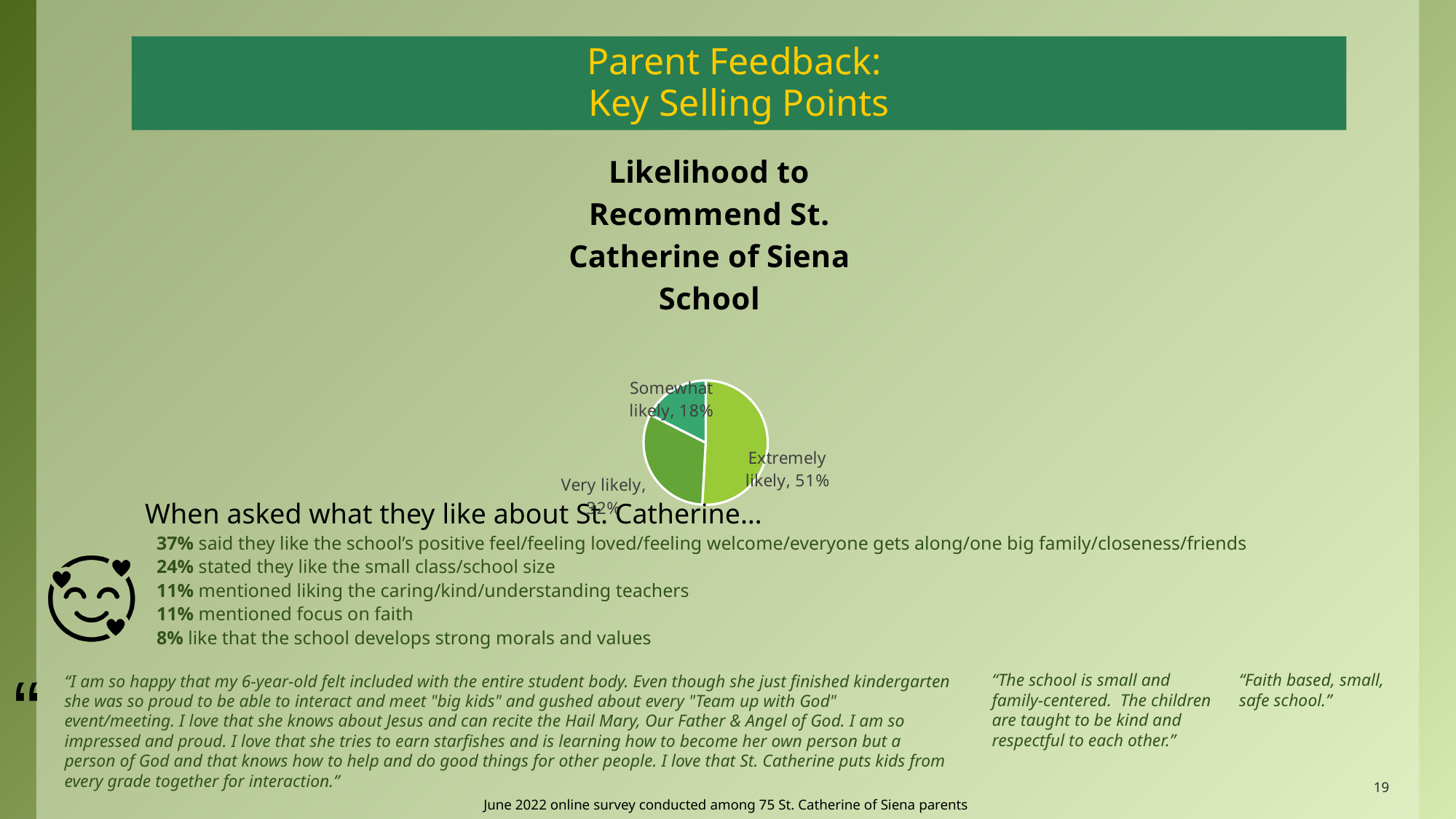
What share of the pie does the Extremely likely slice represent? 51% Which category has the smallest slice of the pie chart? Somewhat likely Is the Extremely likely slice greater or less than half of the pie? greater How many slices does the pie chart have? 3 Which category has the largest slice of the pie chart? Extremely likely Which slice is larger, Very likely or Somewhat likely? Very likely What is the title of the pie chart? Likelihood to Recommend St. Catherine of Siena School What kind of chart is shown on the slide? pie chart What percentage of parents said they are somewhat likely to recommend the school? 18% Which slice is larger, Extremely likely or Somewhat likely? Extremely likely What is the difference in percentage points between the Extremely likely and Somewhat likely slices? 33 What percentage of parents said they are extremely likely to recommend the school? 51%